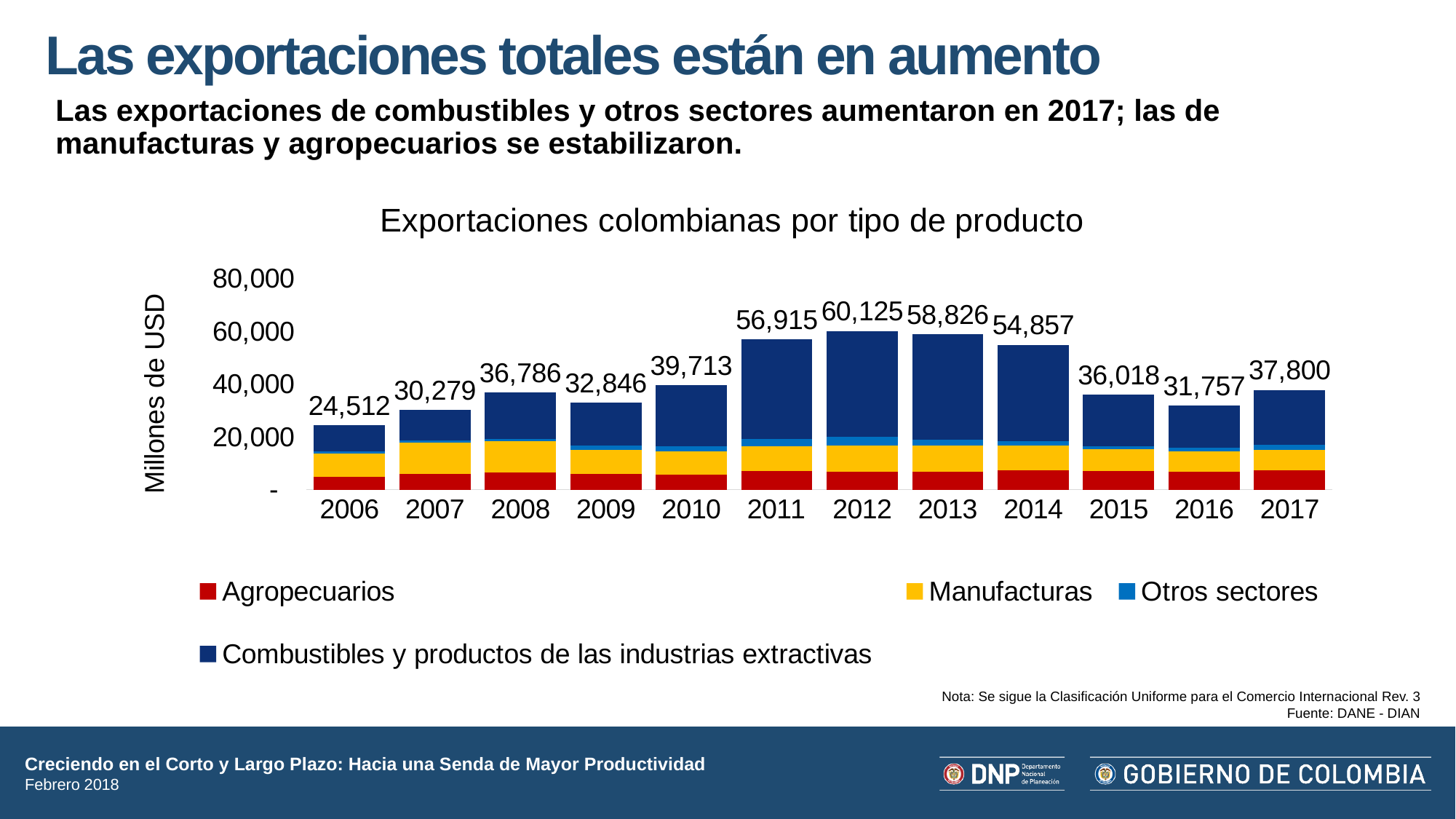
By how much did total exports increase from 2016 to 2017? 6,043 Which year has the lowest total exports in the chart? 2006 Do total exports rise or fall from 2014 to 2016? fall How many series does the legend list? 4 How many years are shown on the x axis of the chart? 12 What is the difference between the total exports of 2012 and 2011? 3,210 Which year has the highest total exports in the chart? 2012 Which year had larger total exports, 2013 or 2014? 2013 What is the total value of exports shown for 2012? 60,125 What is the total value of Colombian exports shown for 2017? 37,800 What kind of chart is shown on the slide? Stacked bar chart Is the value of the Agropecuarios segment in 2017 greater or less than 20,000? less